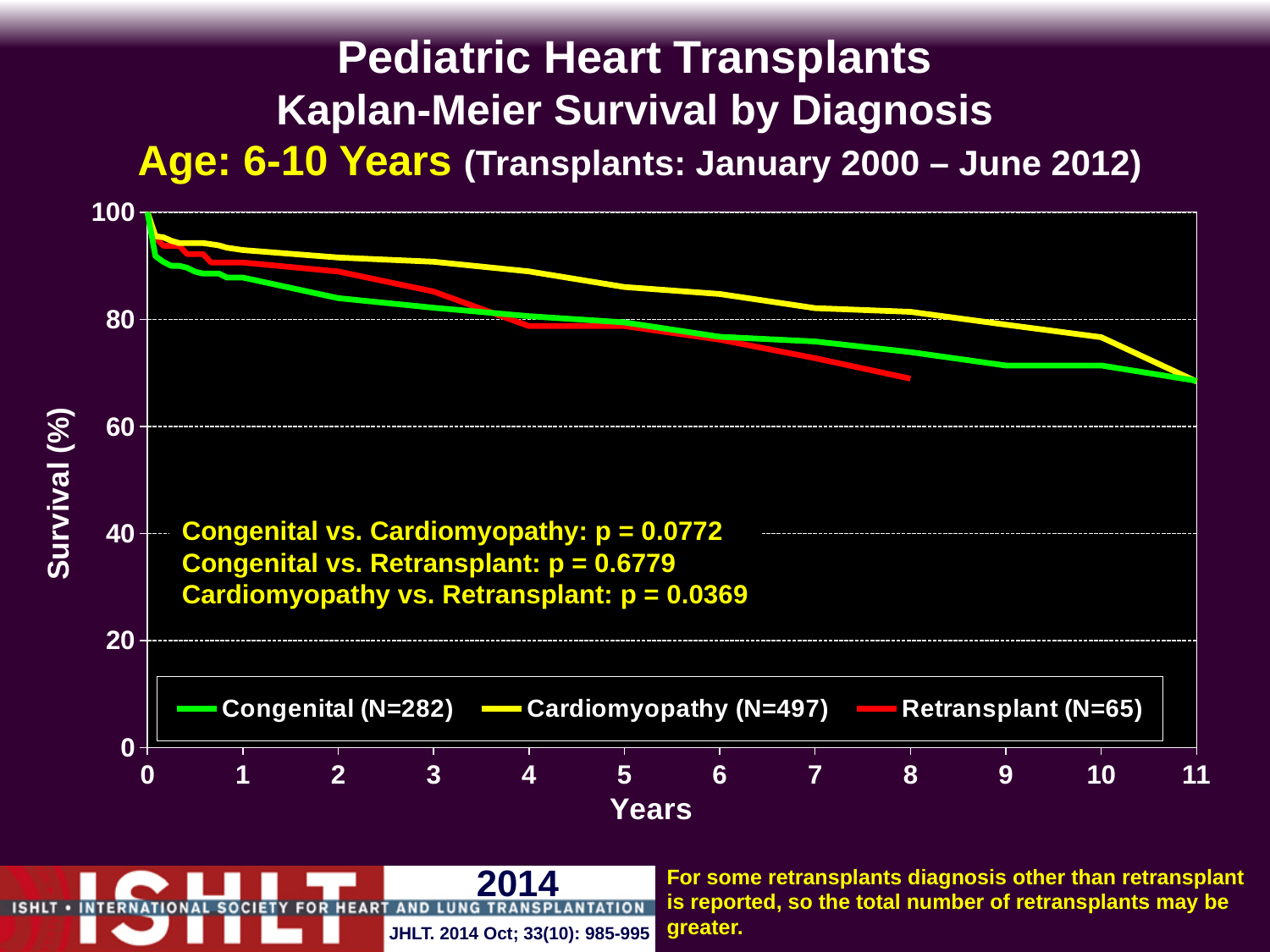
What is the number of patients (N) in the Congenital group shown in the legend? 282 Which diagnosis group has the largest N in the legend? Cardiomyopathy (N=497) Which diagnosis group has the highest survival at 5 years? Cardiomyopathy What is the number of patients (N) in the Retransplant group shown in the legend? 65 At 2 years, which group has higher survival, Cardiomyopathy or Congenital? Cardiomyopathy Do the survival curves rise or fall as years increase? fall Is the survival for Cardiomyopathy at 10 years greater or less than 60? greater How many series does the legend list? 3 What is the p-value shown for Cardiomyopathy vs. Retransplant? 0.0369 What kind of chart is shown on the slide? line chart What is the number of patients (N) in the Cardiomyopathy group shown in the legend? 497 Is the survival for Retransplant at 8 years greater or less than 80? less